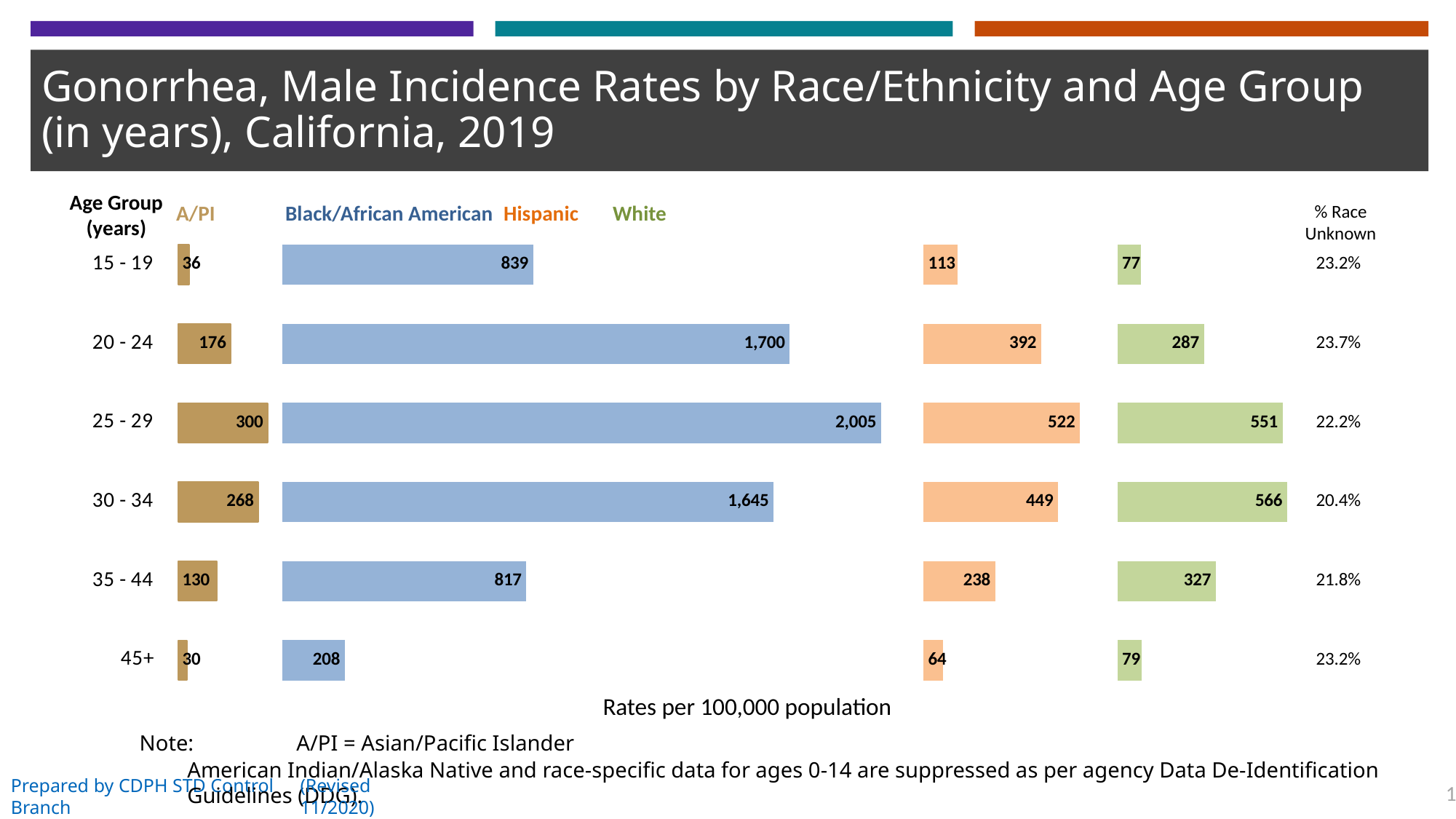
How many age groups are shown in the chart? 6 What is the % Race Unknown value for the 30 - 34 age group? 20.4% For males aged 30 - 34, which is larger: the Hispanic rate or the White rate? White Which age group has the highest gonorrhea incidence rate among Black/African American males? 25 - 29 What is the gonorrhea incidence rate for Black/African American males aged 25 - 29? 2,005 How many race/ethnicity groups are plotted in the chart? 4 What is the gonorrhea incidence rate for White males aged 45+? 79 Which age group has the lowest gonorrhea incidence rate among Hispanic males? 45+ What is the gonorrhea incidence rate for A/PI males aged 30 - 34? 268 What type of chart is shown on the slide? Bar chart What is the difference between the Black/African American rate and the White rate for males aged 20 - 24? 1,413 What is the gonorrhea incidence rate for Hispanic males aged 20 - 24? 392